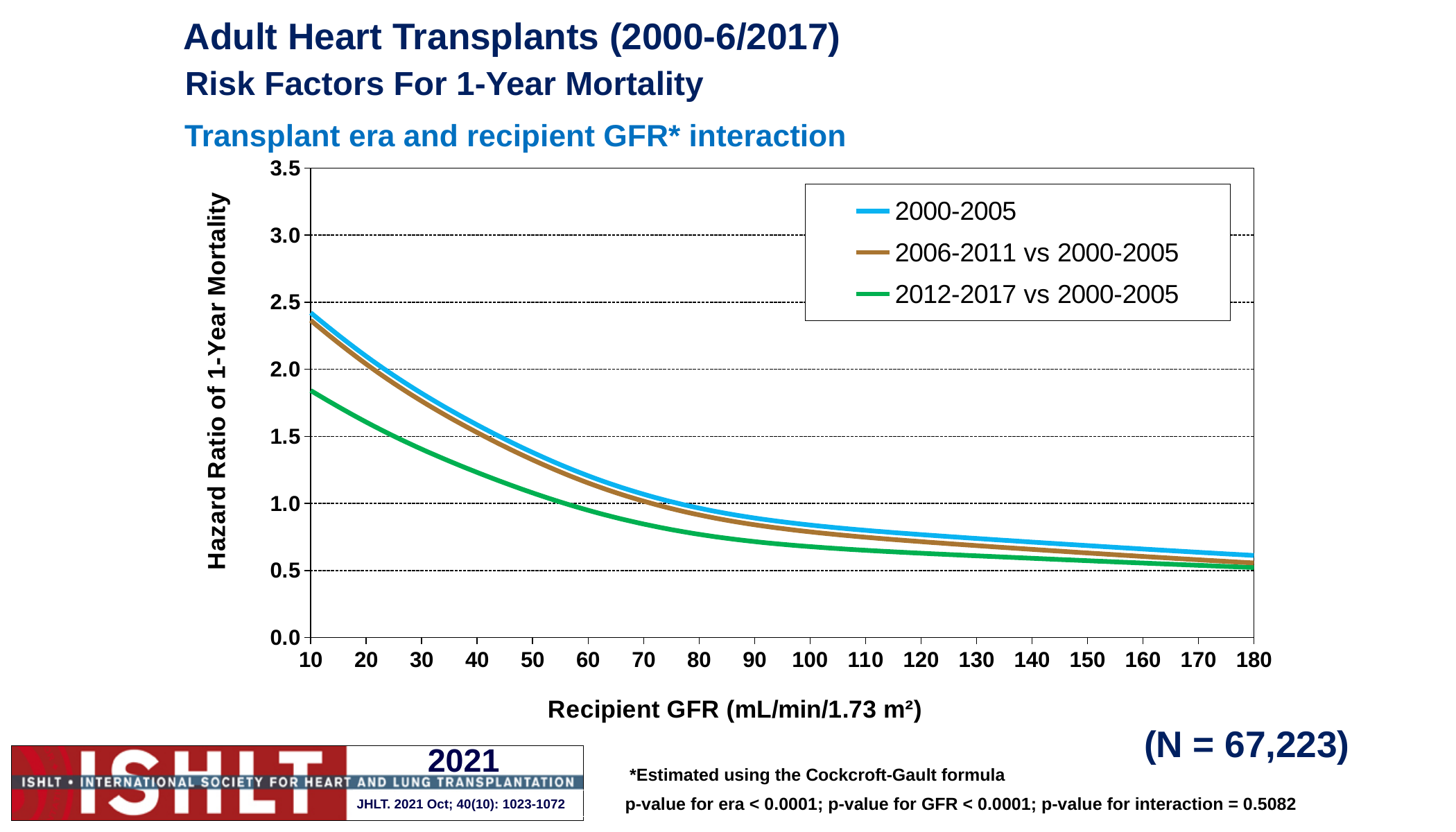
Is the hazard ratio for the 2000-2005 series at a GFR of 180 greater or less than 0.5? greater Is the hazard ratio for the 2000-2005 series at a GFR of 60 greater or less than 1.0? greater Is the hazard ratio for the 2012-2017 vs 2000-2005 series at a GFR of 10 greater or less than 2.0? less How many series does the legend list? 3 What is the label of the y-axis? Hazard Ratio of 1-Year Mortality Which colour is used for the 2006-2011 vs 2000-2005 series? Brown What kind of chart is shown on the slide? Line chart At a GFR of 30, which series has the higher hazard ratio: 2000-2005 or 2012-2017 vs 2000-2005? 2000-2005 How does the hazard ratio for the 2000-2005 series change as recipient GFR increases from 10 to 180? It falls Which series has the lowest hazard ratio across the GFR range shown? 2012-2017 vs 2000-2005